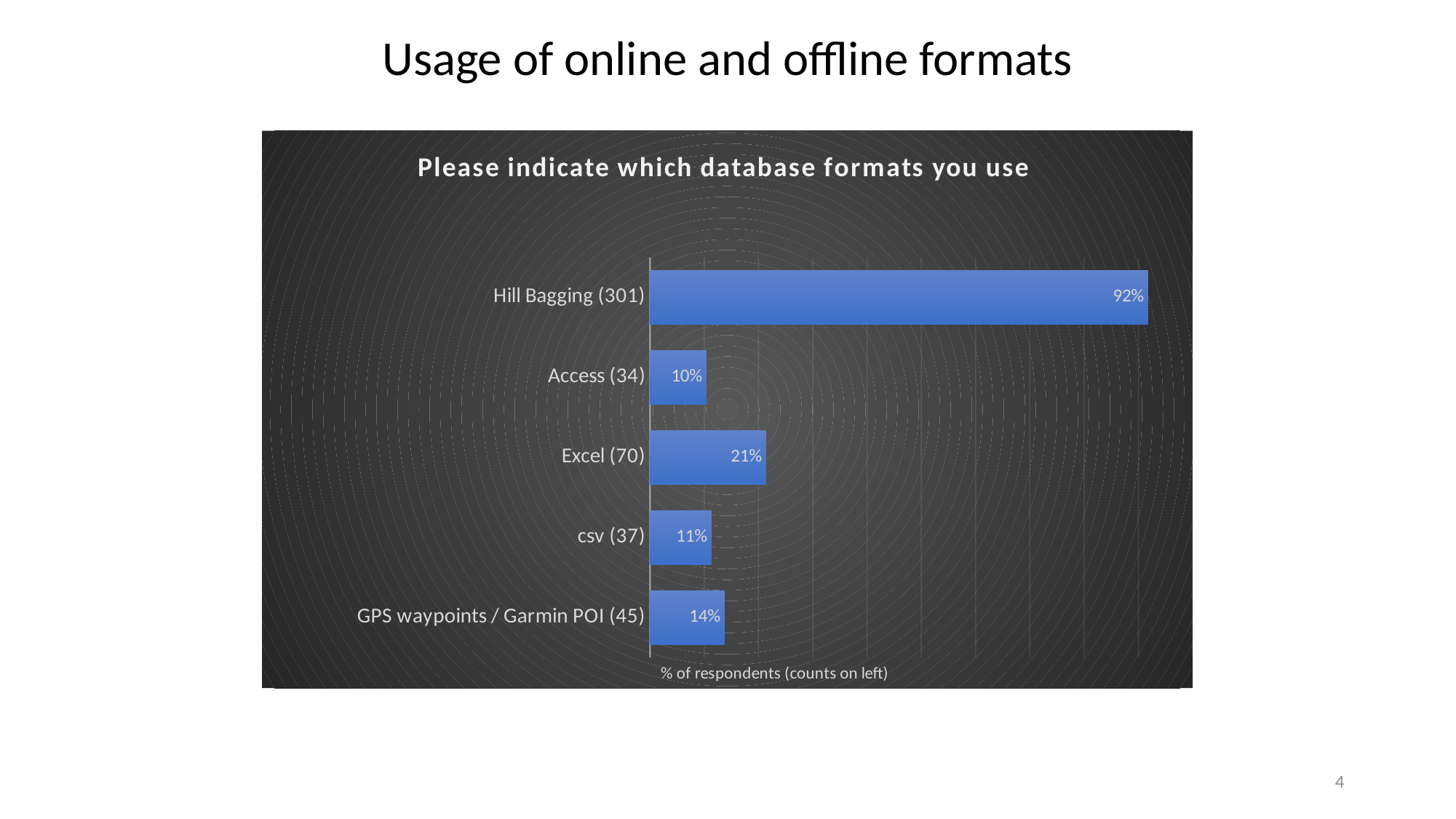
What type of chart is shown on the slide? Bar chart What is the title of the chart? Please indicate which database formats you use What percentage of respondents use GPS waypoints / Garmin POI? 14% Which database format has the lowest percentage of respondents? Access What percentage of respondents use Excel? 21% How many database formats are shown in the chart? 5 What is the difference in percentage points between Excel and Access? 11 What is the difference in percentage points between Hill Bagging and Excel? 71 Which database format has the highest percentage of respondents? Hill Bagging Which has a larger percentage of respondents, csv or GPS waypoints / Garmin POI? GPS waypoints / Garmin POI What percentage of respondents use csv? 11% What percentage of respondents use Hill Bagging? 92%